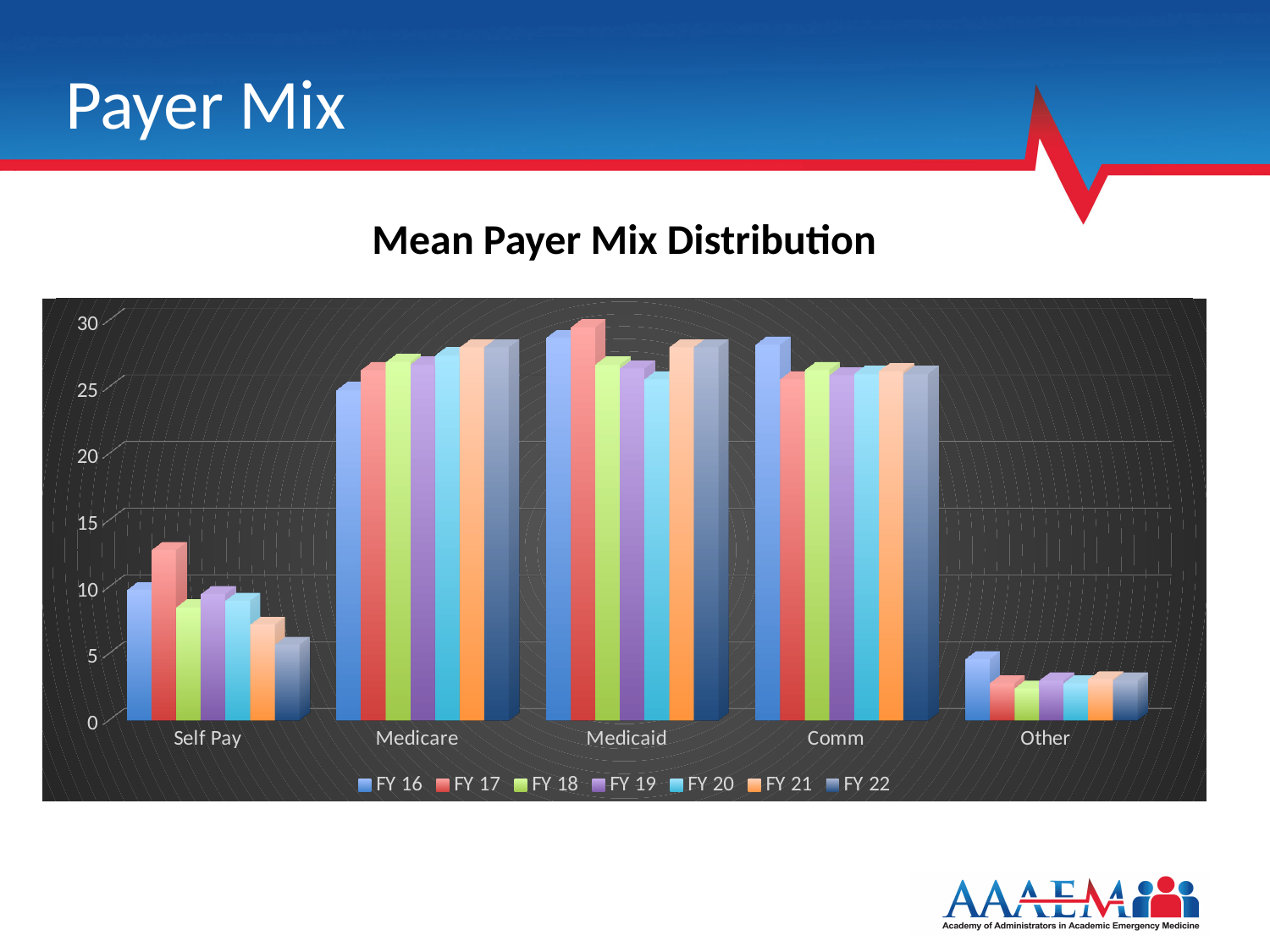
Which fiscal year has the highest value for Self Pay? FY 17 Which fiscal year has the highest value for Other? FY 16 Which payer category has the lowest values across all fiscal years? Other What is the title of the chart? Mean Payer Mix Distribution Is the value for Self Pay in FY 17 greater or less than 10? greater Which is larger: the FY 17 value for Self Pay or the FY 22 value for Self Pay? FY 17 What kind of chart is shown on the slide? bar chart Is the value for Other in FY 18 greater or less than 5? less How many payer categories are shown on the x axis? 5 Which fiscal year has the lowest value for Self Pay? FY 22 How many series does the legend list? 7 Is the value for Medicaid in FY 17 greater or less than 25? greater